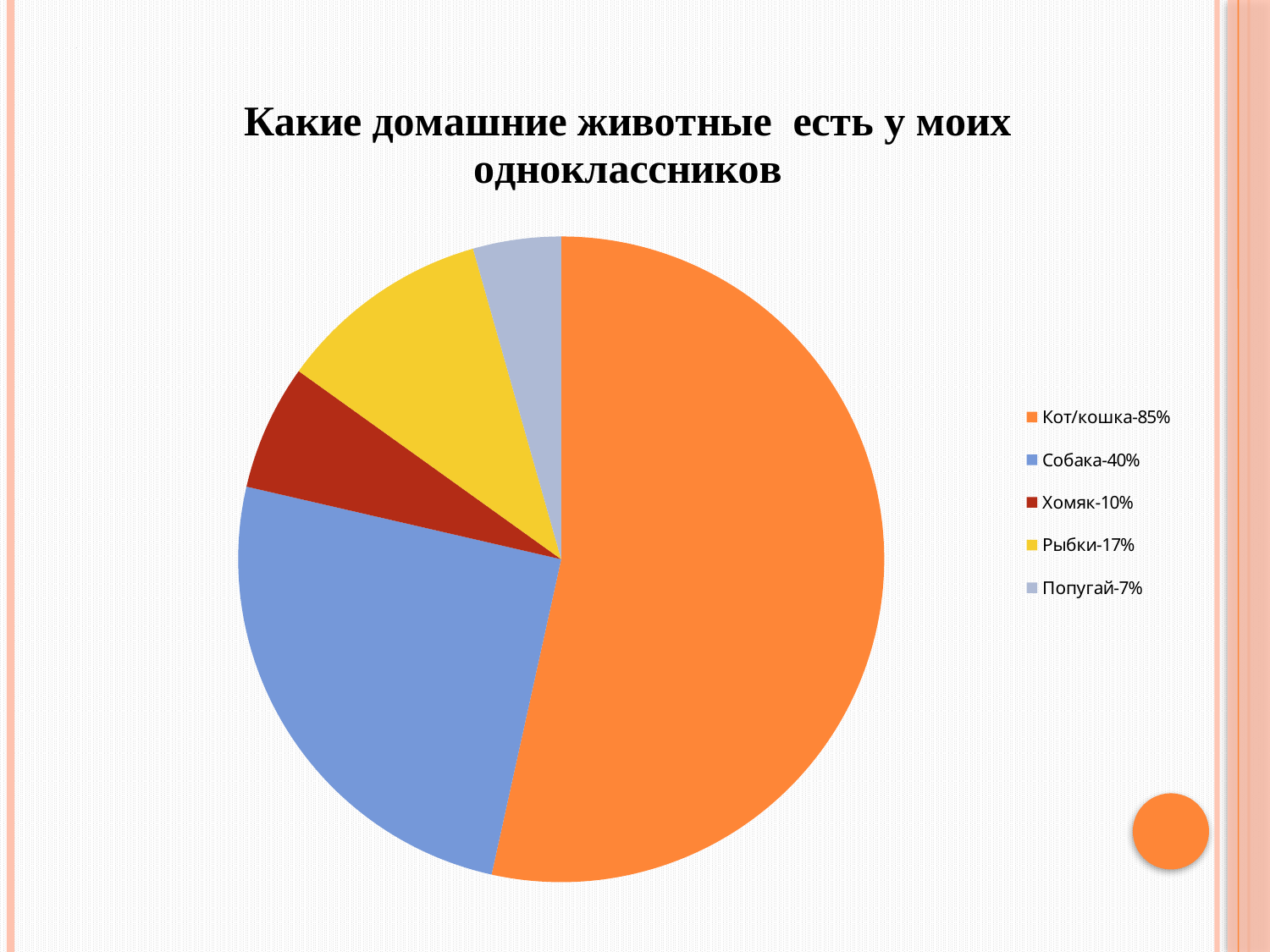
What is the title of the chart? Какие домашние животные есть у моих одноклассников How many categories does the pie chart show? 5 What is the difference between the values for Кот/кошка and Собака? 45% Which category has the highest value? Кот/кошка What kind of chart is shown on the slide? Pie chart Which category has the lowest value? Попугай What is the value shown for Хомяк? 10% What is the value shown for Попугай? 7% What is the value shown for Рыбки? 17% What is the value shown for Кот/кошка? 85% What is the value shown for Собака? 40% Which is larger, the value for Рыбки or the value for Хомяк? Рыбки